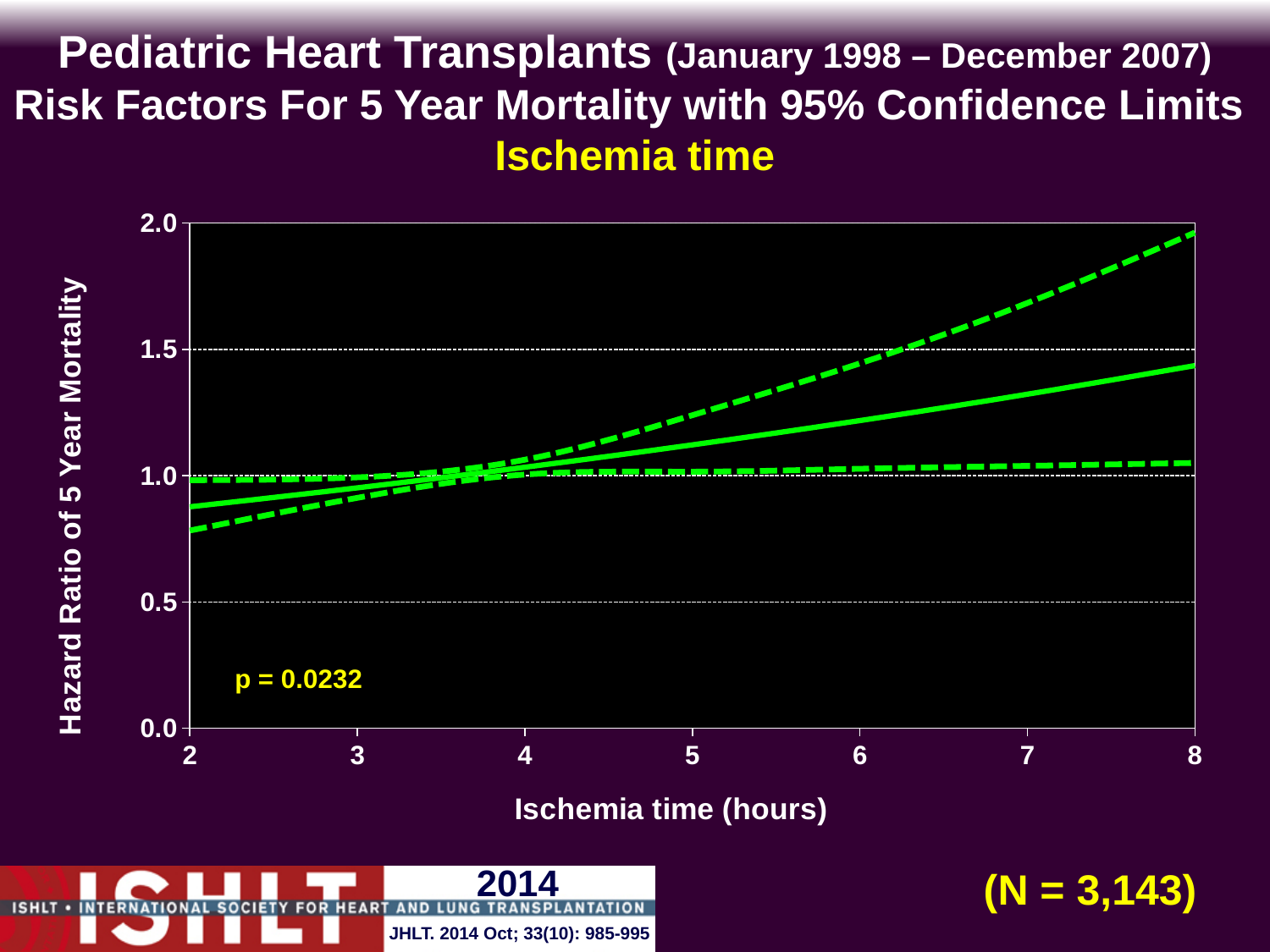
What kind of chart is shown on the slide? line chart What is the label of the x axis? Ischemia time (hours) What is the label of the y axis? Hazard Ratio of 5 Year Mortality What is the sample size (N) shown on the slide? N = 3,143 Is the hazard ratio (solid line) at 6 hours of ischemia time greater or less than 1.0? greater Is the hazard ratio (solid line) at 8 hours of ischemia time greater or less than 1.5? less How many lines are plotted on the chart? 3 Is the hazard ratio (solid line) at 2 hours of ischemia time greater or less than 1.0? less What p-value is printed on the chart? p = 0.0232 Does the solid hazard ratio line rise or fall as ischemia time increases from 2 to 8 hours? rise